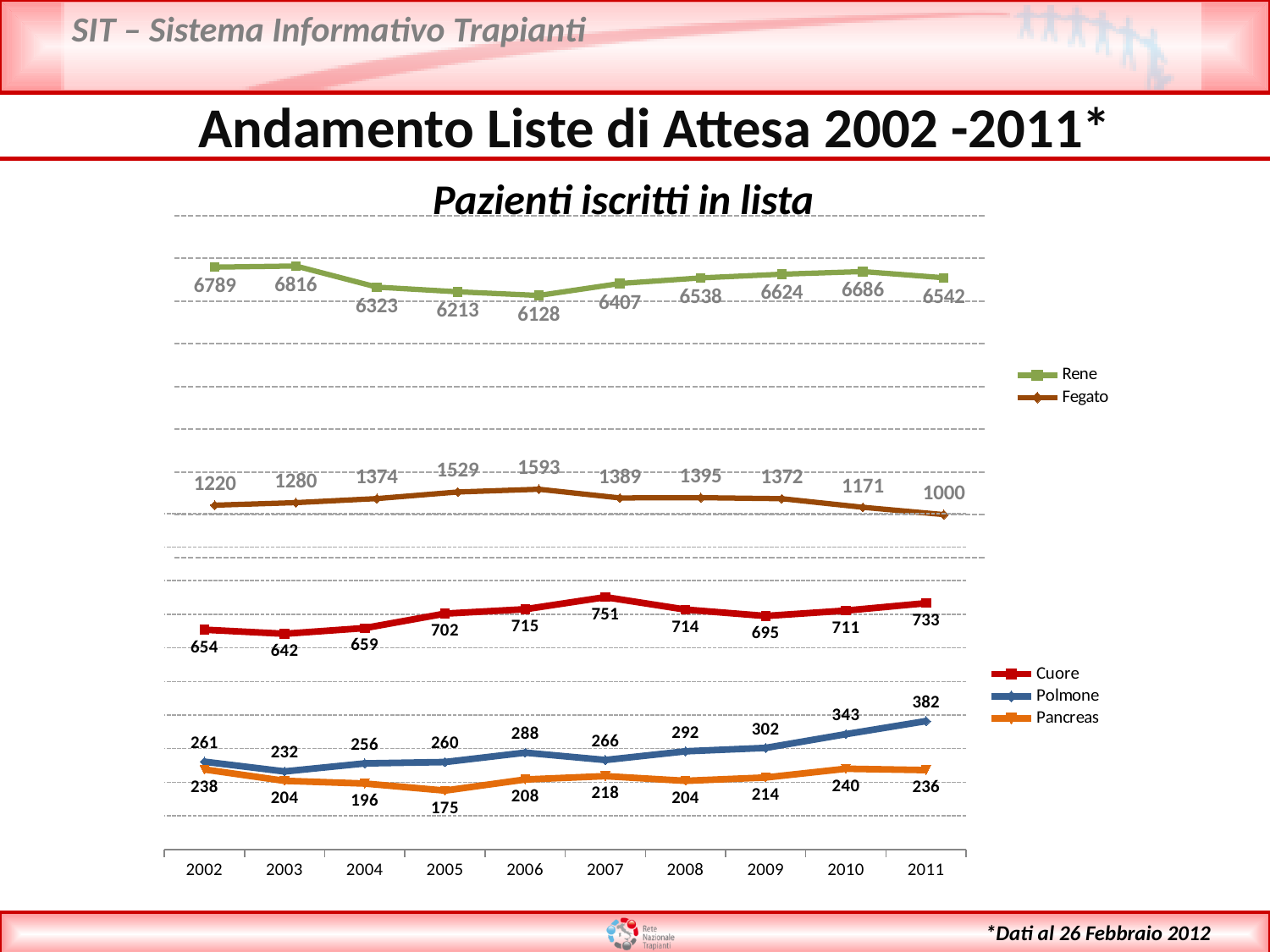
What kind of chart is used on this slide? Line chart In the top chart (Rene and Fegato), what is the difference between the Rene values in 2003 and 2002? 27 In the bottom chart (Cuore, Polmone, Pancreas), in which year is the Pancreas value lowest? 2005 In the top chart (Rene and Fegato), what is the value for Rene in 2006? 6128 In the bottom chart (Cuore, Polmone, Pancreas), what is the value for Polmone in 2011? 382 How many years are shown on the x axis? 10 In the bottom chart (Cuore, Polmone, Pancreas), in which year is the Cuore value highest? 2007 In the top chart (Rene and Fegato), how many series does the legend list? 2 In the top chart (Rene and Fegato), in which year is the Rene value lowest? 2006 In the bottom chart (Cuore, Polmone, Pancreas), which is larger in 2010: Polmone or Pancreas? Polmone In the top chart (Rene and Fegato), in which year is the Fegato value highest? 2006 In the top chart (Rene and Fegato), what is the value for Fegato in 2011? 1000